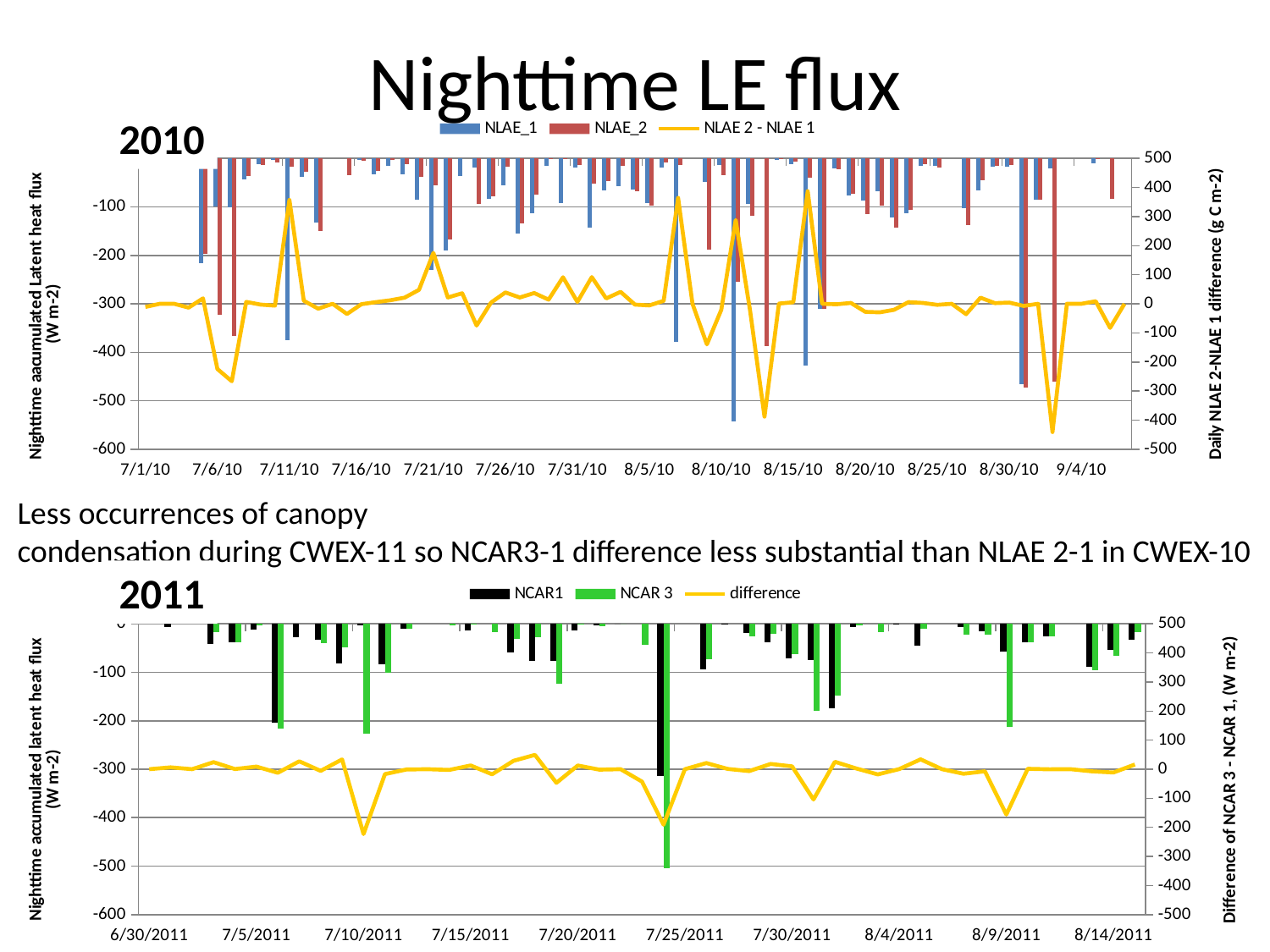
In the 2011 chart (bottom), how many series does the legend list? 3 In the 2010 chart (top), which series is drawn as a yellow line? NLAE 2 - NLAE 1 In the 2010 chart (top), how many series does the legend list? 3 In the 2011 chart (bottom), which series is drawn with green bars? NCAR 3 In the 2010 chart (top), is the lowest point of the NLAE 2 - NLAE 1 line (around 9/2/10) greater or less than -400 on the right axis? less In the 2011 chart (bottom), is the difference line around 7/10/2011 greater or less than -100 on the right axis? less In the 2010 chart (top), is the peak of the NLAE 2 - NLAE 1 line near 7/11/10 greater or less than 300 on the right axis? greater What kind of chart is the 2010 chart (top)? A combination of a bar chart and a line chart